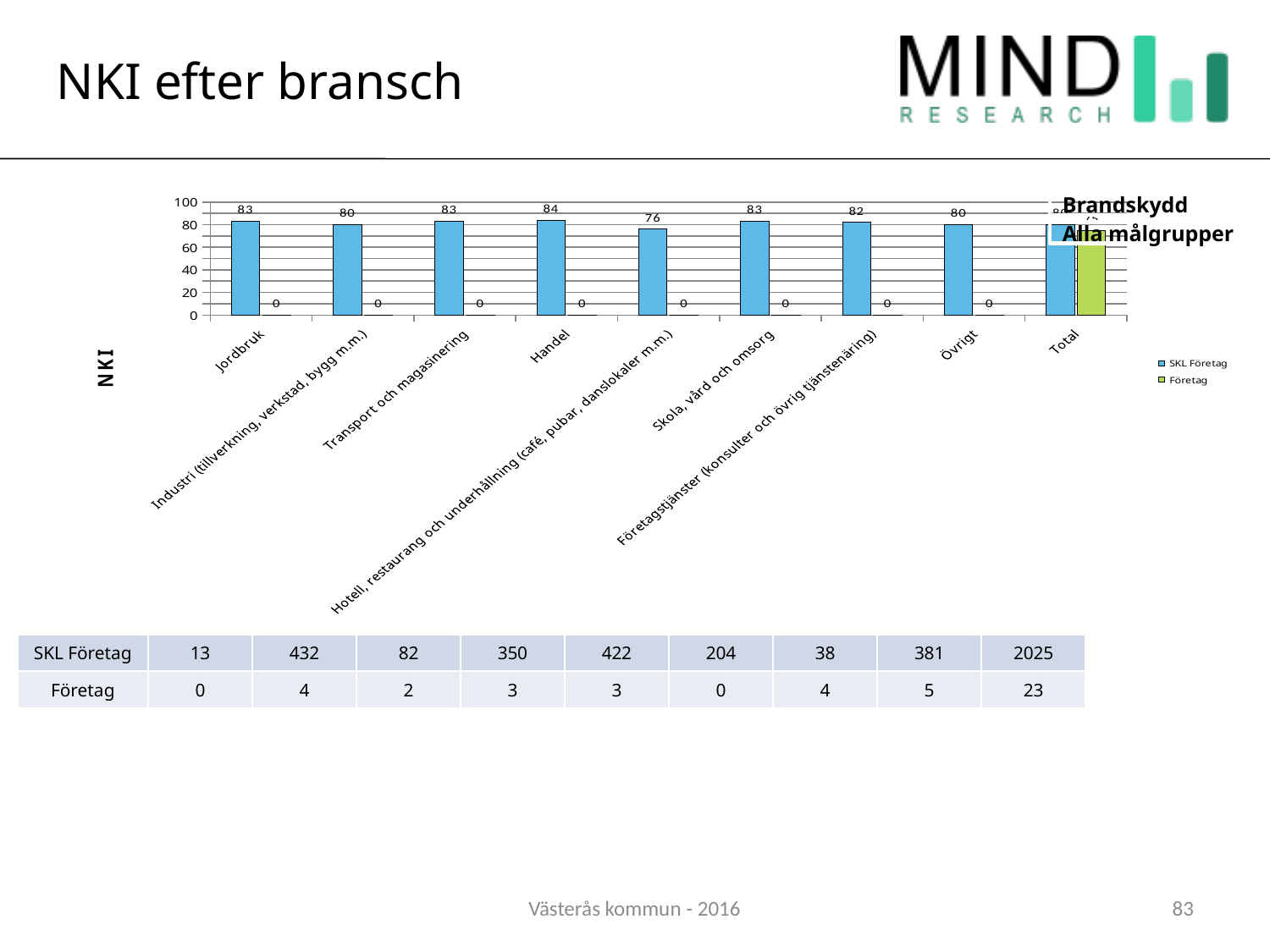
What is the SKL Företag value for Hotell, restaurang och underhållning (café, pubar, danslokaler m.m.)? 76 Among the branch categories (excluding Total), which has the highest SKL Företag value? Handel What is the SKL Företag value for Handel? 84 Is the SKL Företag value for Övrigt greater or less than 60? greater What is the SKL Företag value for Jordbruk? 83 What is the difference between the SKL Företag values for Handel and Hotell, restaurang och underhållning? 8 What kind of chart is shown on the slide? Bar chart Among the branch categories (excluding Total), which has the lowest SKL Företag value? Hotell, restaurang och underhållning (café, pubar, danslokaler m.m.) What is the Företag value for Skola, vård och omsorg? 0 How many categories are shown on the x axis of the chart? 9 Which has a larger SKL Företag value, Industri (tillverkning, verkstad, bygg m.m.) or Transport och magasinering? Transport och magasinering How many series does the legend list? 2